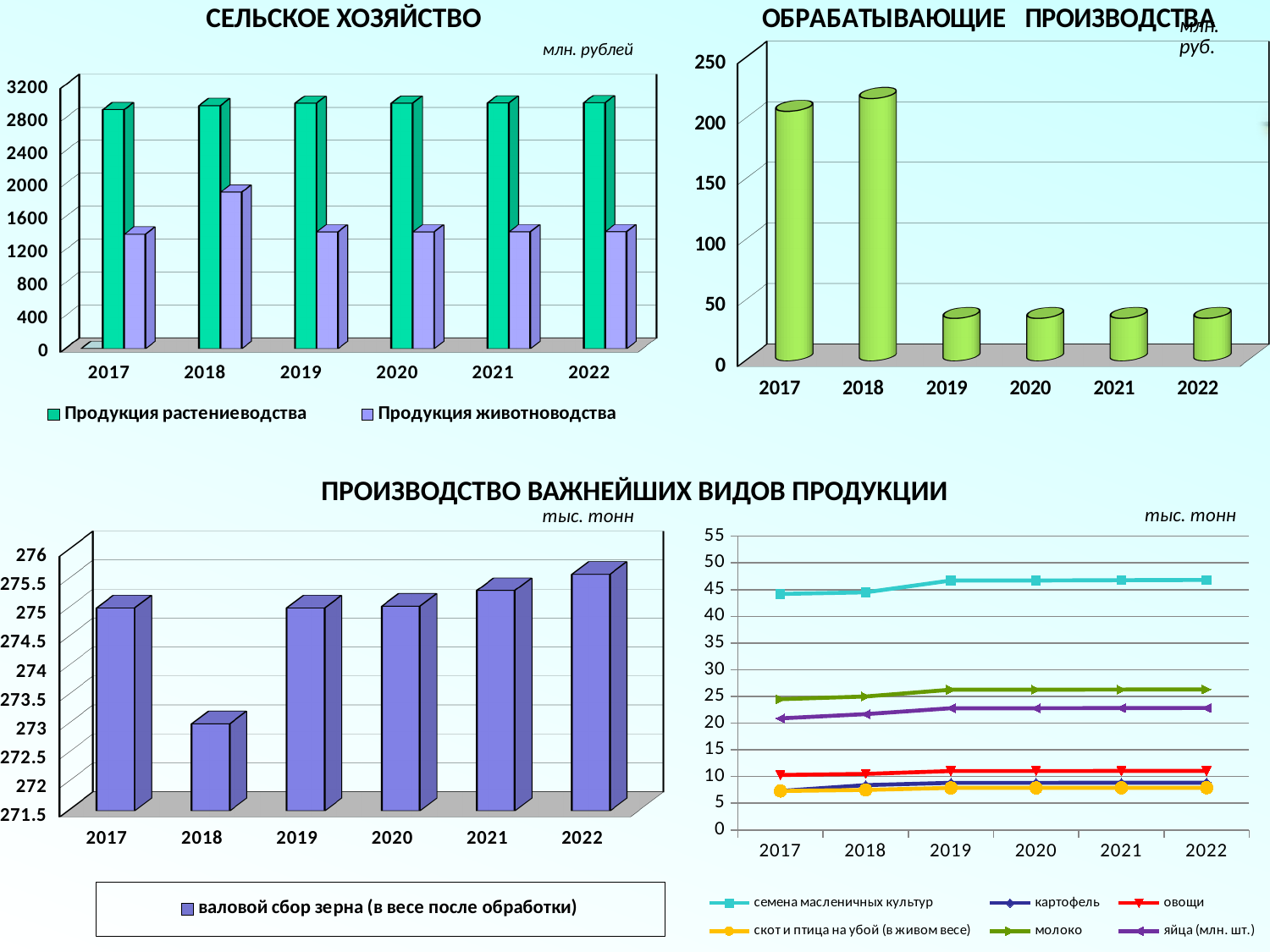
In the chart titled ОБРАБАТЫВАЮЩИЕ ПРОИЗВОДСТВА, how many years are shown on the x axis? 6 In the chart titled СЕЛЬСКОЕ ХОЗЯЙСТВО, which is larger in 2019: Продукция растениеводства or Продукция животноводства? Продукция растениеводства In the chart titled СЕЛЬСКОЕ ХОЗЯЙСТВО, in which year is Продукция животноводства highest? 2018 In the chart titled СЕЛЬСКОЕ ХОЗЯЙСТВО, is the value for Продукция растениеводства in 2017 greater or less than 2400? greater In the chart titled ОБРАБАТЫВАЮЩИЕ ПРОИЗВОДСТВА, which year has the highest value? 2018 In the bottom-right line chart, how many series does the legend list? 6 What kind of chart is the bottom-right chart under ПРОИЗВОДСТВО ВАЖНЕЙШИХ ВИДОВ ПРОДУКЦИИ? line chart In the bottom-left chart (валовой сбор зерна), which year has the lowest value? 2018 In the chart titled СЕЛЬСКОЕ ХОЗЯЙСТВО, how many series does the legend list? 2 In the chart titled ОБРАБАТЫВАЮЩИЕ ПРОИЗВОДСТВА, is the value for 2019 greater or less than 50? less In the bottom-right line chart, is the value for семена масленичных культур in 2022 greater or less than 45? greater